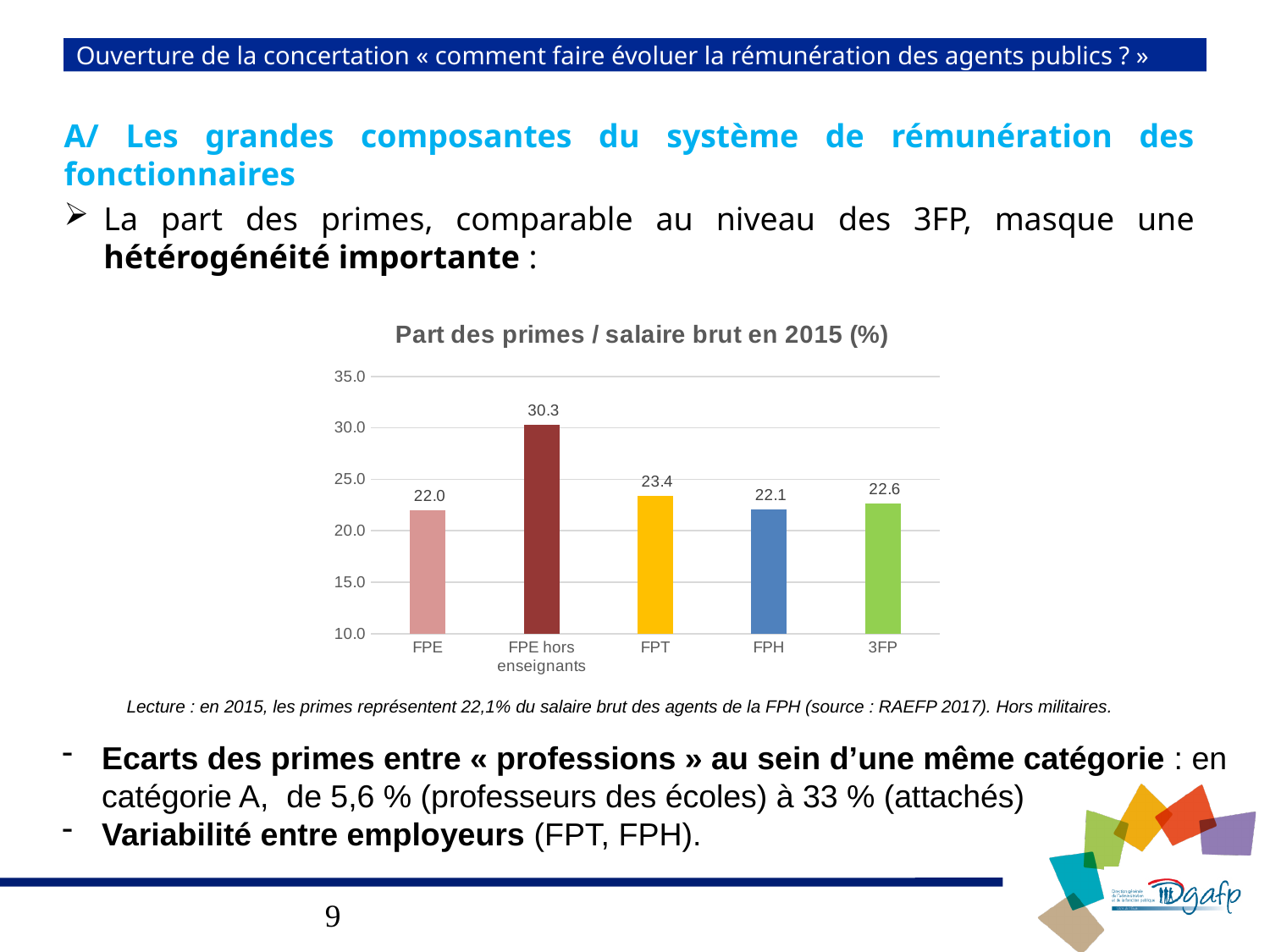
Which category has the lowest value in the chart? FPE What is the value for FPE hors enseignants in the chart 'Part des primes / salaire brut en 2015 (%)'? 30.3 What is the title of the chart? Part des primes / salaire brut en 2015 (%) What is the value for FPH in the chart? 22.1 What kind of chart is shown on the slide? bar chart Is the value for FPE hors enseignants greater or less than 30.0? greater Which is larger, the value for FPT or the value for 3FP? FPT What is the difference between the values for FPE hors enseignants and FPE? 8.3 How many categories are shown on the x axis of the chart? 5 What is the difference between the values for FPT and FPH? 1.3 What is the value for 3FP in the chart? 22.6 Which category has the highest value in the chart? FPE hors enseignants